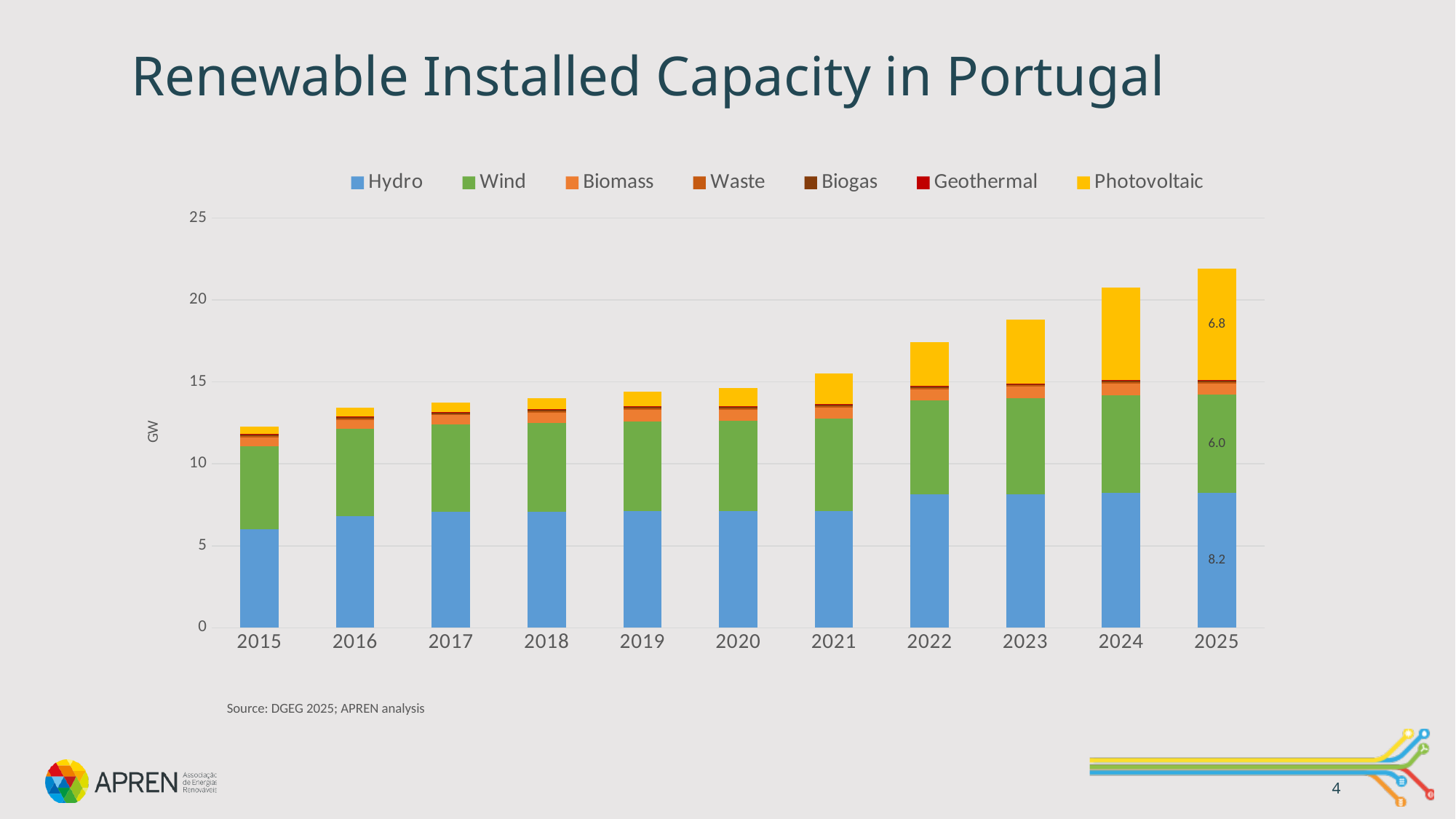
What is the Wind installed capacity in 2025? 6.0 What is the title of the chart? Renewable Installed Capacity in Portugal How many series does the legend list? 7 Is the total installed capacity in 2024 greater or less than 20 GW? greater Which year has the lowest total renewable installed capacity? 2015 How many years are shown on the x axis? 11 What is the difference between the Hydro and Wind values in 2025? 2.2 What is the Photovoltaic installed capacity in 2025? 6.8 What type of chart is shown on the slide? stacked bar chart Which year has the highest total renewable installed capacity? 2025 What is the Hydro installed capacity in 2025? 8.2 In 2025, which is larger, the Hydro value or the Photovoltaic value? Hydro